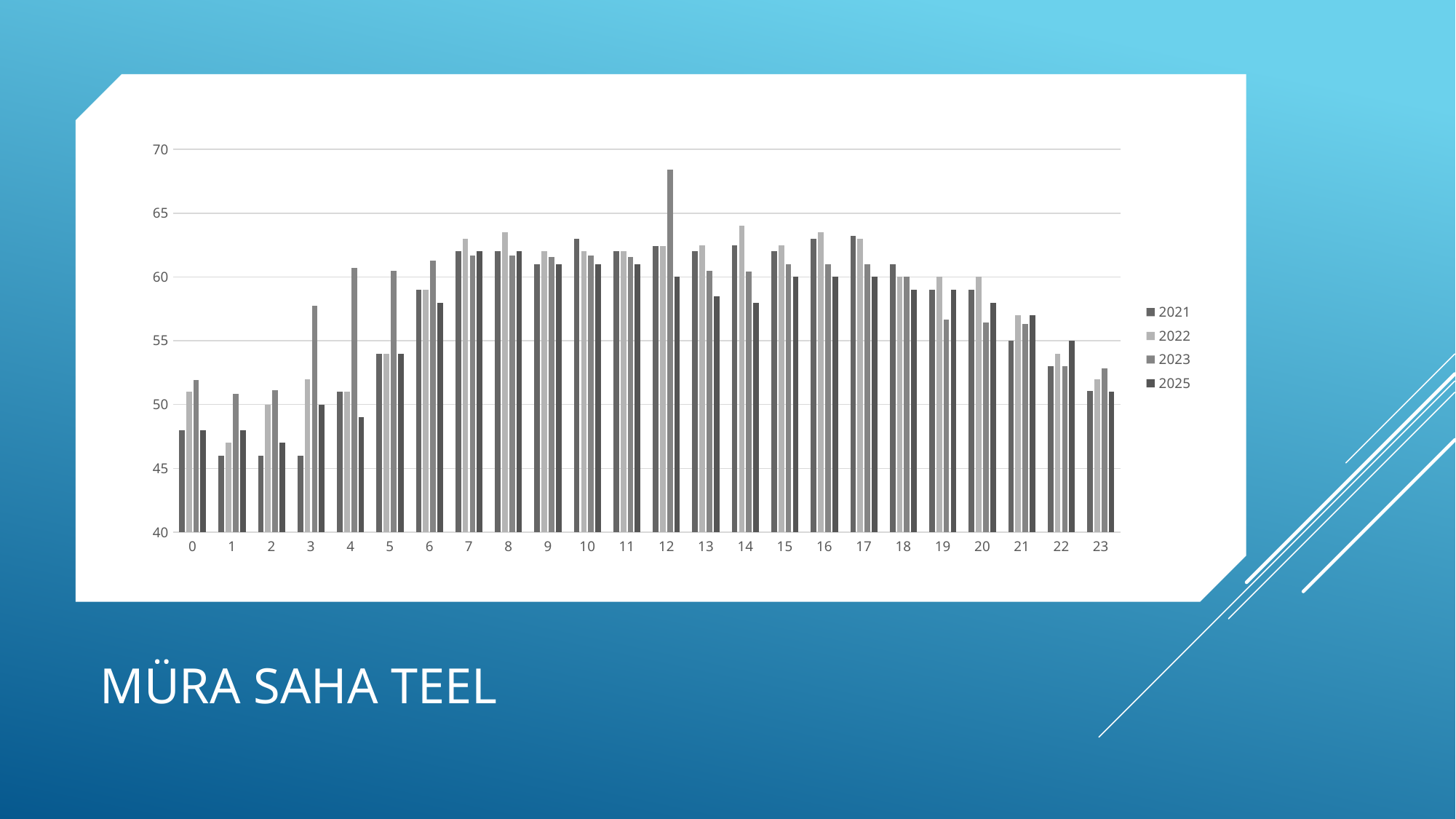
What kind of chart is shown on the slide? bar chart Which years are listed in the legend? 2021, 2022, 2023, 2025 Is the value for 2021 at category 7 greater or less than 60? greater How many series does the legend list? 4 How many categories are shown along the x axis? 24 Do the 2021 values generally rise or fall from category 17 to category 23? fall Is the value for 2023 at category 12 greater or less than 65? greater At category 3, which is larger: the 2021 value or the 2023 value? 2023 Is the value for 2021 at category 1 greater or less than 50? less Which category and series has the tallest bar in the chart? 2023 at category 12 At category 14, which is larger: the 2022 value or the 2025 value? 2022